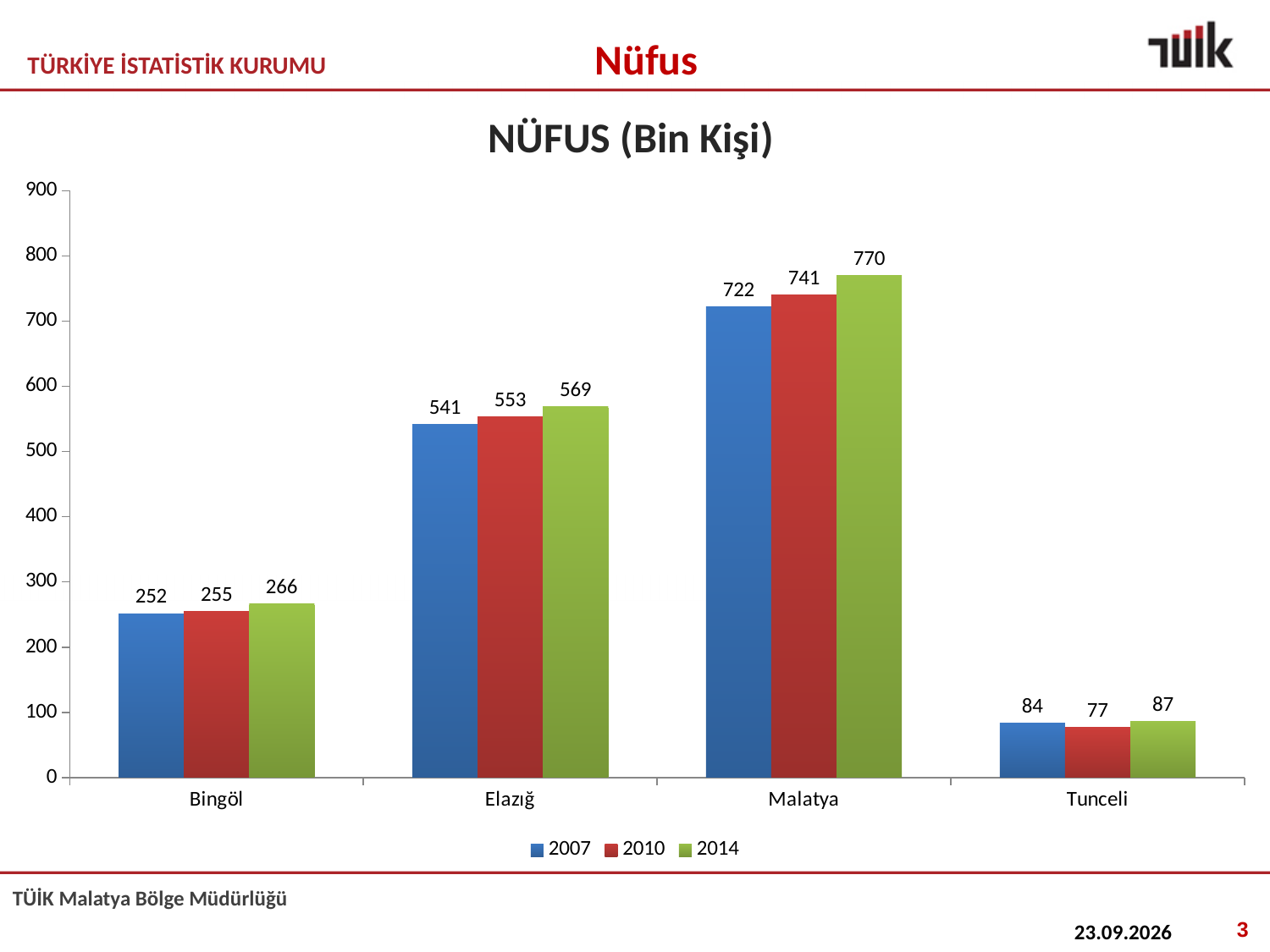
What is the population value for Bingöl in 2007? 252 What is the population value for Malatya in 2014? 770 How many provinces are shown on the x axis? 4 What kind of chart is shown on the slide? Bar chart Which province has the highest population in 2014? Malatya What is the title of the chart? NÜFUS (Bin Kişi) What is the difference between Elazığ's population in 2014 and in 2007? 28 What is the population value for Tunceli in 2010? 77 How many series does the legend list? 3 Which is larger: Bingöl's population in 2010 or Tunceli's population in 2014? Bingöl's population in 2010 Is the value for Elazığ in 2010 greater or less than 500? greater Which province has the lowest population in 2007? Tunceli